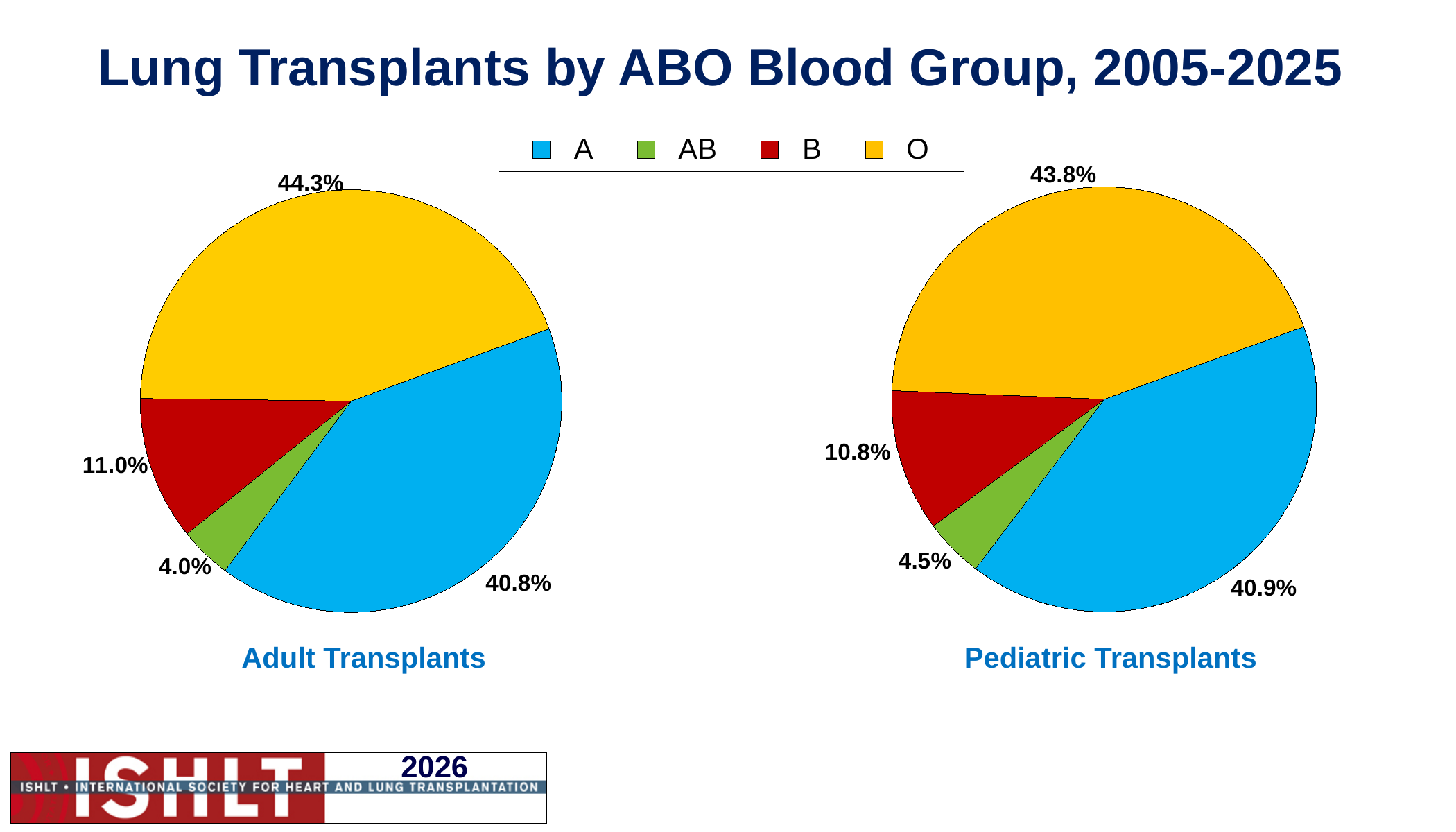
In the Pediatric Transplants pie chart, which blood group has the smallest share? AB In the Pediatric Transplants pie chart, what share of lung transplants is blood group A? 40.9% In the Adult Transplants pie chart, what is the difference between the shares of blood group O and blood group A? 3.5% In the Adult Transplants pie chart, what share is blood group AB? 4.0% Which colour represents blood group AB in the legend? Green What type of chart is used for the Adult Transplants and Pediatric Transplants data? Pie chart In the Adult Transplants pie chart, which blood group has the largest share? O How many blood group categories does each pie chart show? 4 In the Pediatric Transplants pie chart, what share is blood group B? 10.8% Is the share of blood group B larger in the Adult Transplants chart or the Pediatric Transplants chart? Adult Transplants In the Pediatric Transplants pie chart, what is the difference between the shares of blood group B and blood group AB? 6.3% In the Adult Transplants pie chart, what share of lung transplants is blood group O? 44.3%